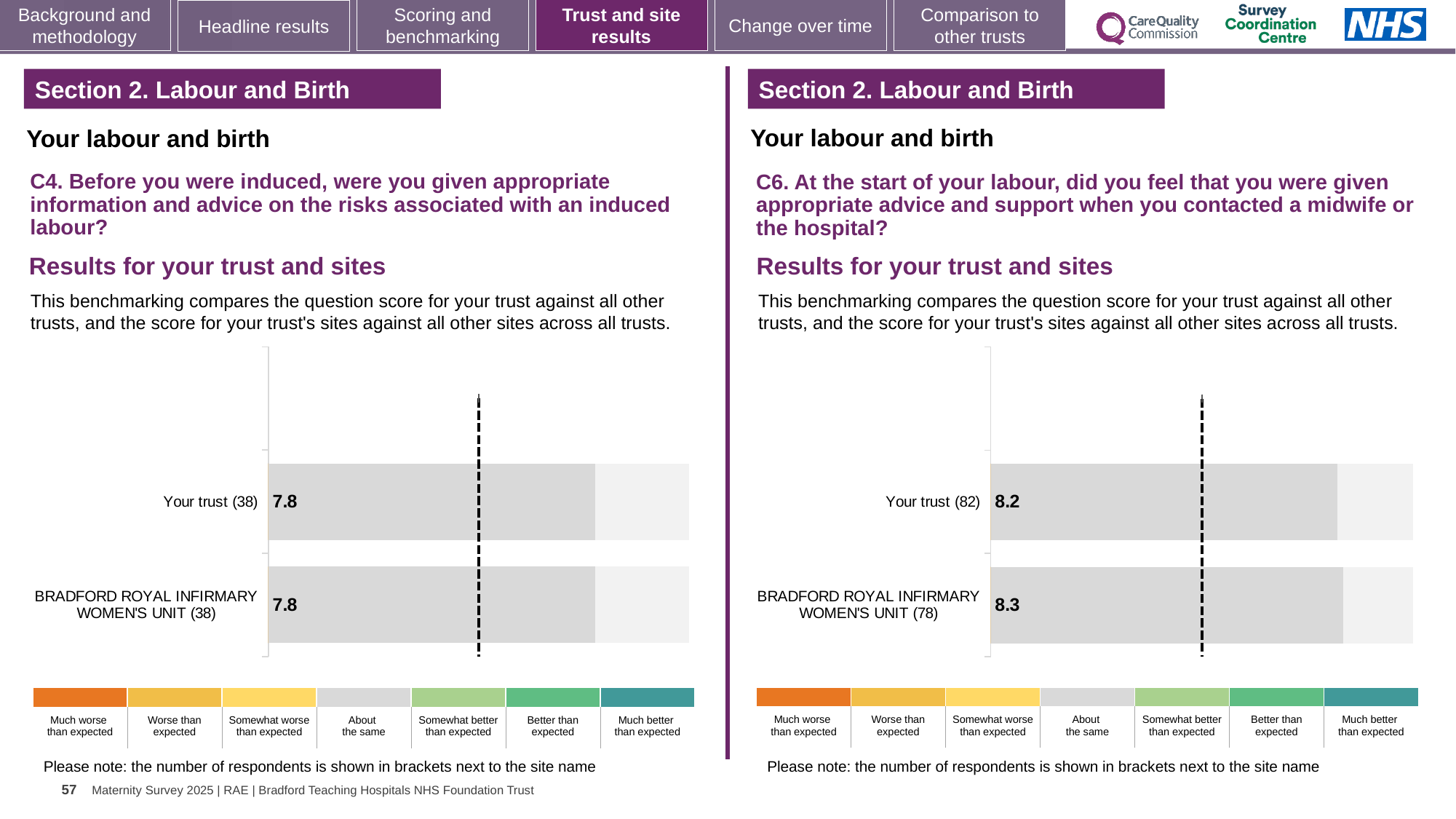
In the C4 chart on the left, what is the score for Bradford Royal Infirmary Women's Unit (38)? 7.8 In the C6 chart on the right, what is the score for Bradford Royal Infirmary Women's Unit (78)? 8.3 In the C6 chart on the right, which has the higher score: Your trust or Bradford Royal Infirmary Women's Unit? Bradford Royal Infirmary Women's Unit In the C6 chart on the right, what is the score for Your trust (82)? 8.2 How many bars are plotted in the C6 chart on the right? 2 In the C4 chart on the left, what is the score for Your trust (38)? 7.8 In the C6 chart on the right, what is the difference between the score for Bradford Royal Infirmary Women's Unit and the score for Your trust? 0.1 How many bars are plotted in the C4 chart on the left? 2 What type of chart is used in the C6 chart on the right? Bar chart How many categories does the colour key below the C4 chart on the left list? 7 In the C4 chart on the left, is the score for Your trust higher than, lower than, or the same as the score for Bradford Royal Infirmary Women's Unit? the same In the C6 chart on the right, how many respondents are shown in brackets for Your trust? 82